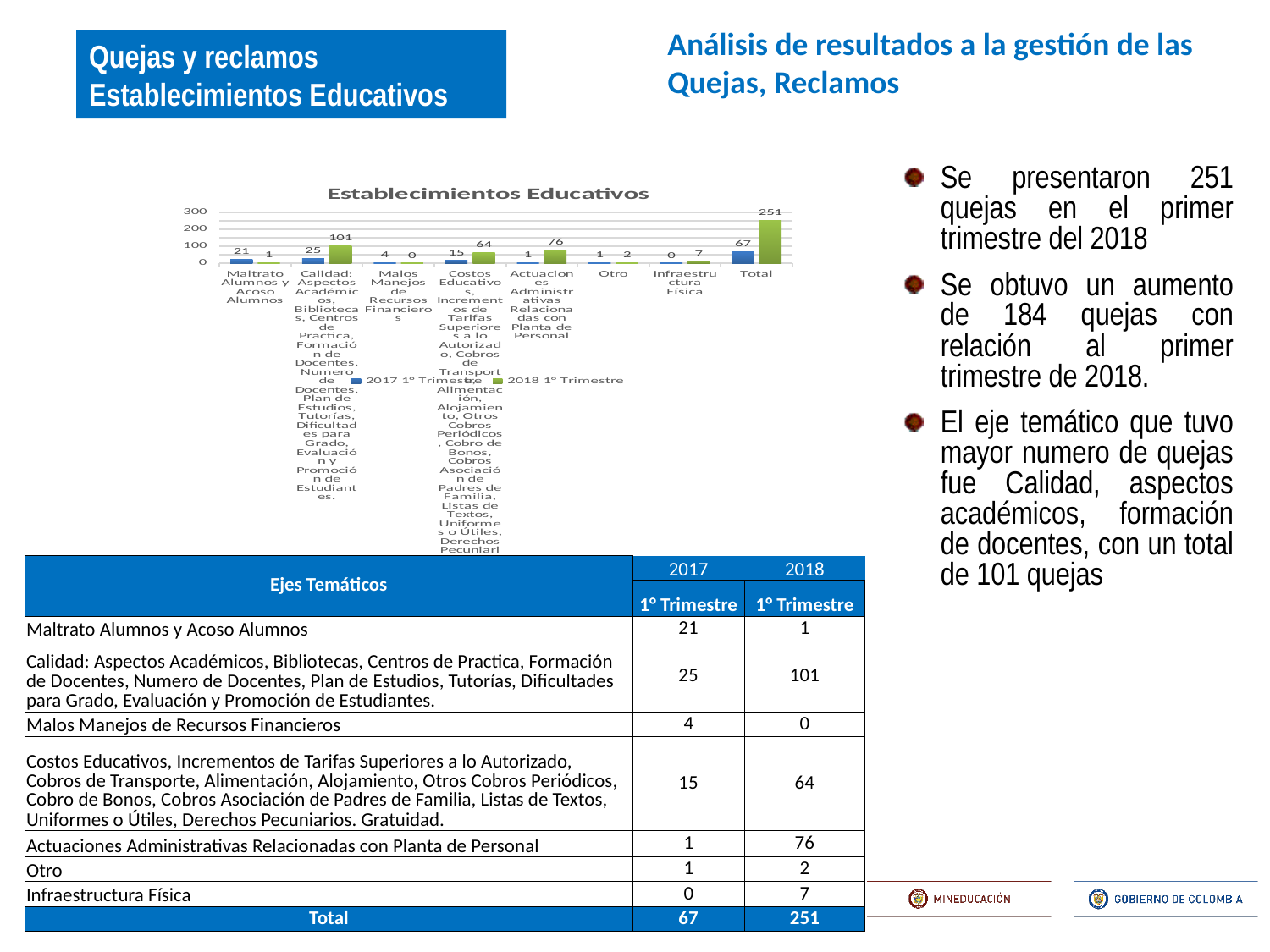
Excluding Total, which category has the lowest value in the 2018 1° Trimestre series? Malos Manejos de Recursos Financieros What is the value for Otro in the 2018 1° Trimestre series? 2 For Maltrato Alumnos y Acoso Alumnos, which series has the larger value, 2017 1° Trimestre or 2018 1° Trimestre? 2017 1° Trimestre Is the Total value for 2018 1° Trimestre greater or less than 200? greater What is the value for Infraestructura Física in the 2018 1° Trimestre series? 7 Excluding Total, which category has the highest value in the 2018 1° Trimestre series? Calidad: Aspectos Académicos, Bibliotecas, Centros de Practica, Formación de Docentes, Numero de Docentes, Plan de Estudios, Tutorías, Dificultades para Grado, Evaluación y Promoción de Estudiantes. What type of chart is shown on the slide? bar chart What is the value for Total in the 2018 1° Trimestre series? 251 What is the difference between the Total values for 2018 1° Trimestre and 2017 1° Trimestre? 184 What is the value for Maltrato Alumnos y Acoso Alumnos in the 2017 1° Trimestre series? 21 How many series does the chart legend list? 2 What is the title of the chart? Establecimientos Educativos